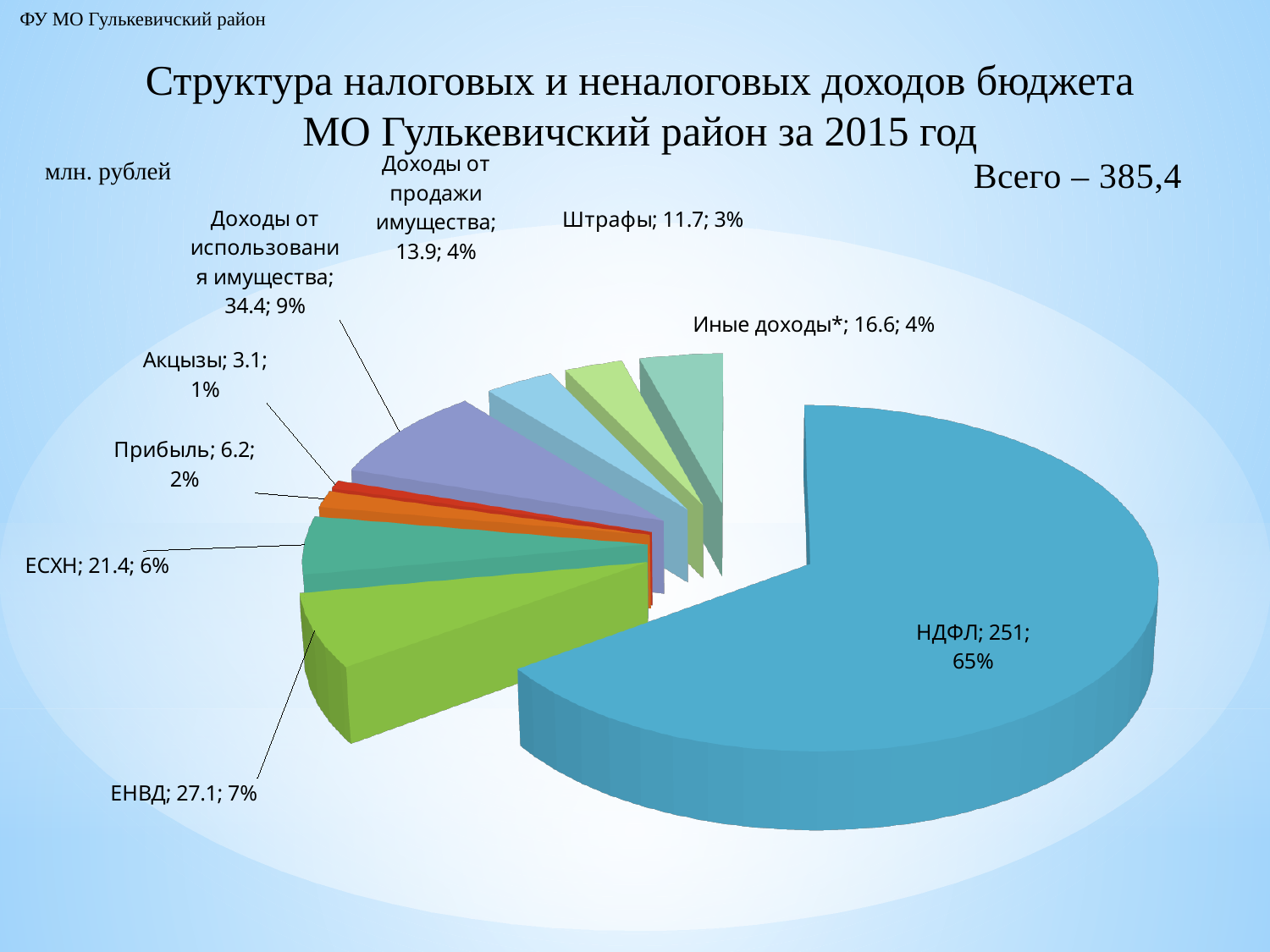
What type of chart is shown on the slide? pie chart Which category has the smallest slice? Акцызы What is the value for ЕНВД? 27.1 Which category has the largest slice? НДФЛ Which is larger, the value for Иные доходы* or the value for Доходы от продажи имущества? Иные доходы* What total is stated on the slide for the chart? 385,4 What is the value for НДФЛ? 251 What share of the pie does Штрафы represent? 3% How many slices does the pie chart have? 9 What is the value for Доходы от использования имущества? 34.4 What is the difference between the values for ЕНВД and ЕСХН? 5.7 What share of the pie does НДФЛ represent? 65%